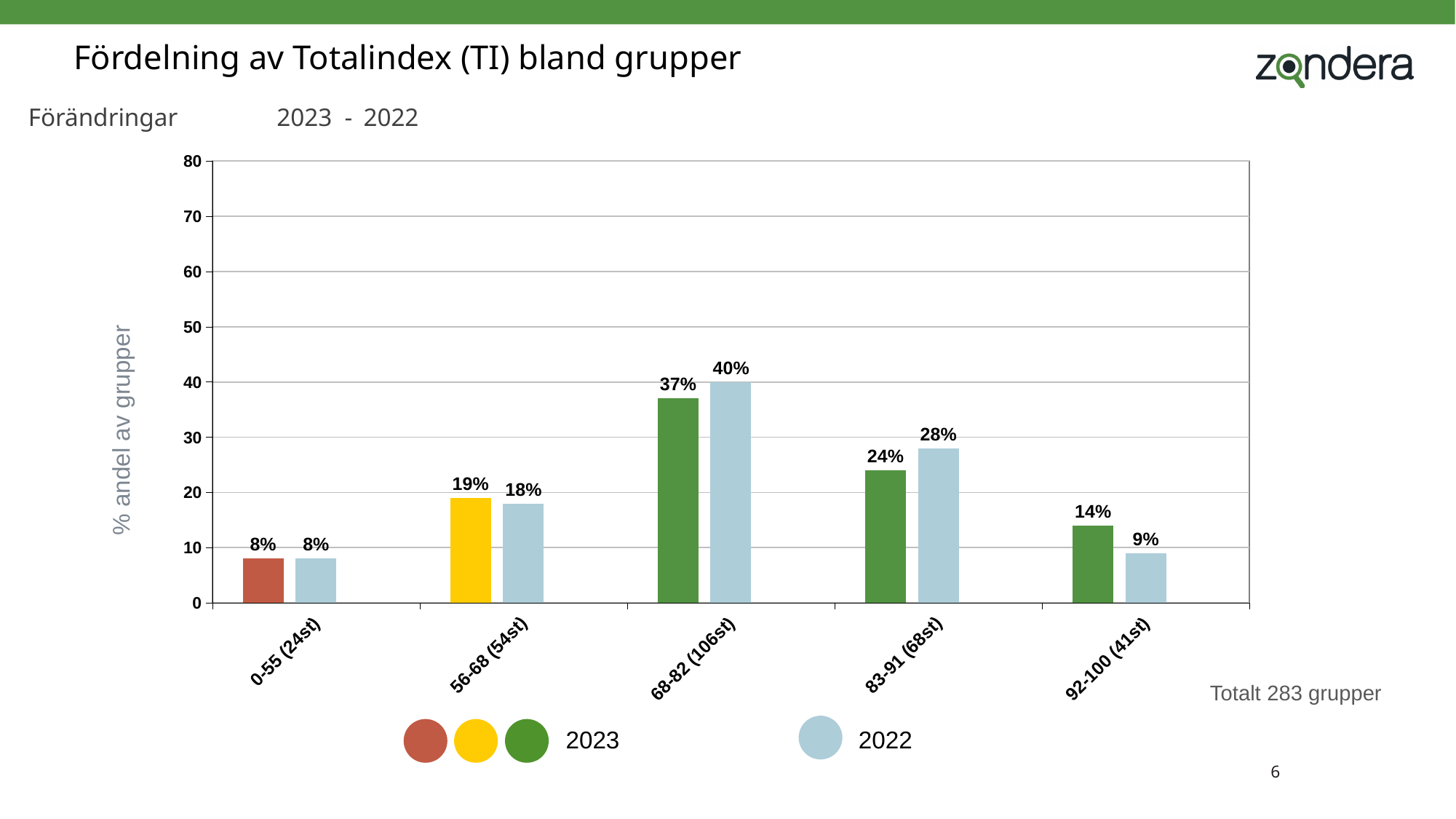
How many categories are shown on the x axis? 5 Which category has the lowest 2023 value? 0-55 (24st) What kind of chart is shown on the slide? bar chart What is the difference between the 2022 and 2023 values for the 68-82 (106st) category? 3% What is the 2023 value for the 92-100 (41st) category? 14% Which category has the highest 2022 value? 68-82 (106st) What is the difference between the 2023 and 2022 values for the 92-100 (41st) category? 5% What is the label of the y axis? % andel av grupper Which is larger for the 56-68 (54st) category, the 2023 value or the 2022 value? 2023 What is the 2022 value for the 83-91 (68st) category? 28% How many series does the legend list? 2 What is the 2023 value for the 68-82 (106st) category? 37%